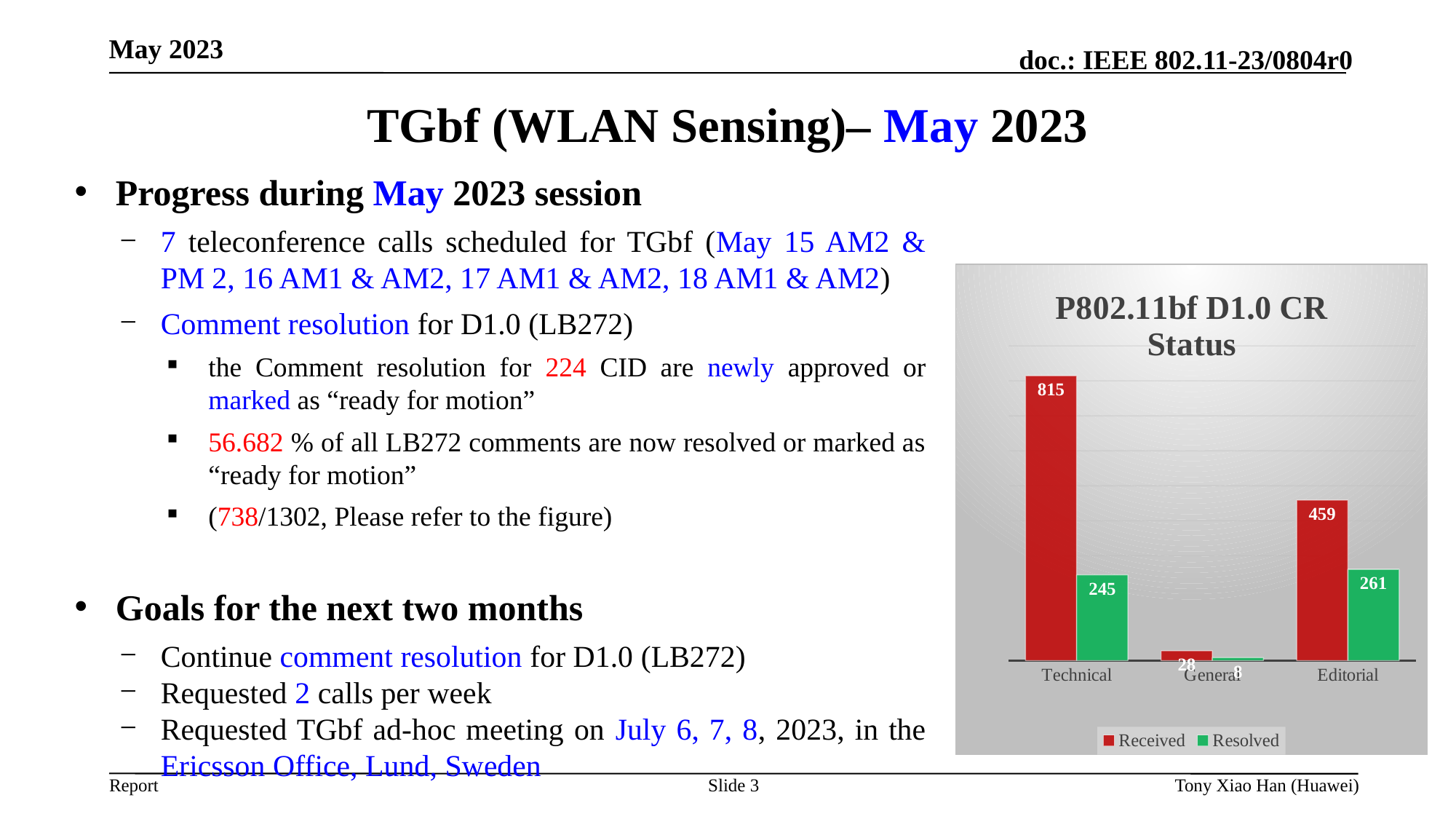
What is the Resolved value for Editorial in the P802.11bf D1.0 CR Status chart? 261 What is the Resolved value for Technical in the P802.11bf D1.0 CR Status chart? 245 What is the difference between the Received values for Technical and Editorial in the P802.11bf D1.0 CR Status chart? 356 What is the difference between the Received and Resolved values for Technical in the P802.11bf D1.0 CR Status chart? 570 Which category has the highest Received value in the P802.11bf D1.0 CR Status chart? Technical Which category has the lowest Resolved value in the P802.11bf D1.0 CR Status chart? General How many categories are shown on the x axis of the P802.11bf D1.0 CR Status chart? 3 What type of chart is the P802.11bf D1.0 CR Status chart? bar chart How many series does the legend of the P802.11bf D1.0 CR Status chart list? 2 What is the Received value for Technical in the P802.11bf D1.0 CR Status chart? 815 In the P802.11bf D1.0 CR Status chart, is the Resolved value for Editorial larger or smaller than the Resolved value for Technical? larger What is the Received value for General in the P802.11bf D1.0 CR Status chart? 28